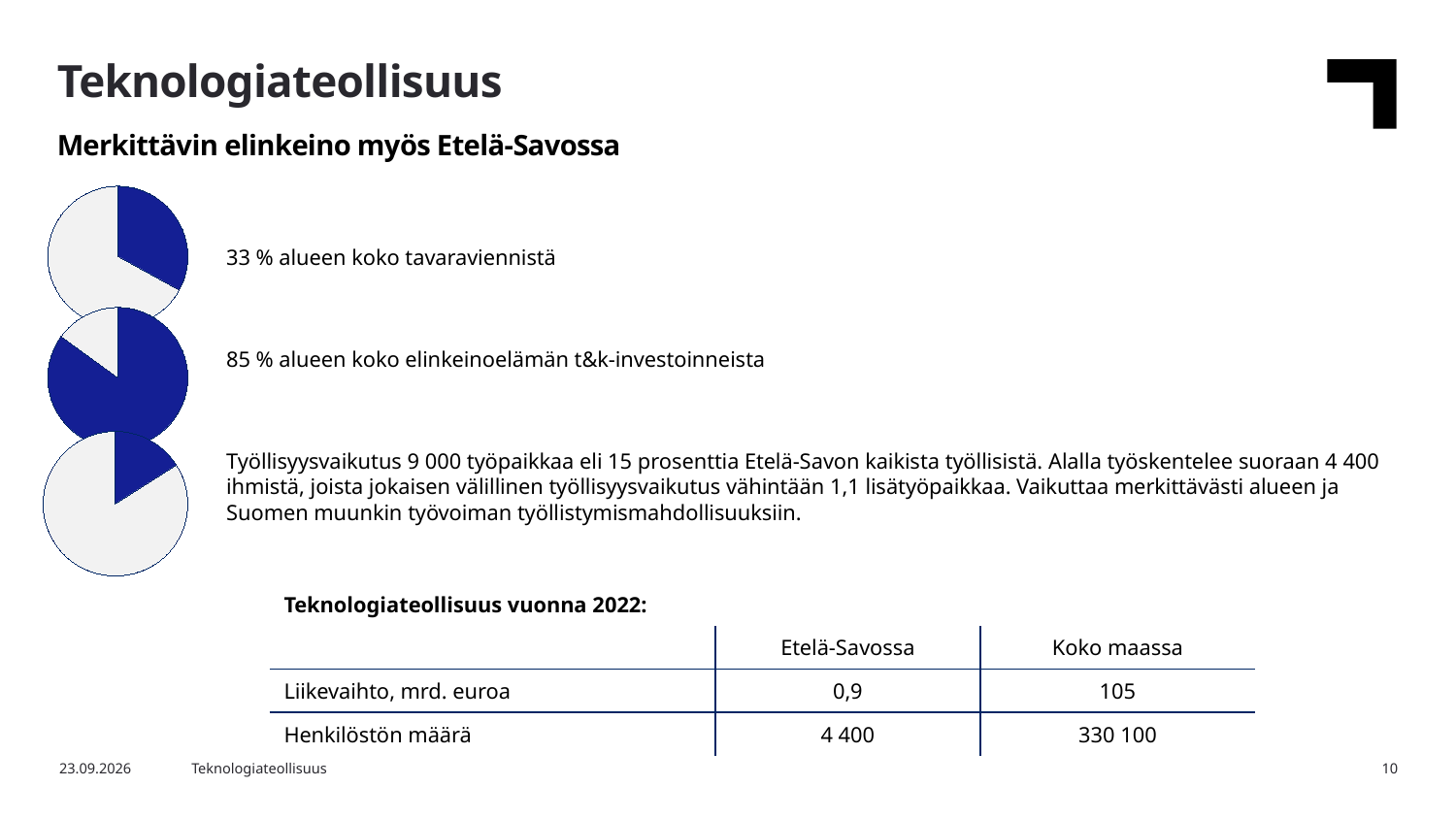
In the top pie chart, what share of the region's total goods exports does the blue slice represent? 33 % What kind of charts are shown on the left side of the slide? Pie charts How many pie charts are on the slide? 3 In the bottom pie chart, what share of all employed people in Etelä-Savo does the blue slice represent? 15 prosenttia How many slices does each pie chart have? 2 Which of the three pie charts has the smallest blue slice? The bottom pie chart (15 prosenttia) In the middle pie chart, what share of the region's business R&D investments does the blue slice represent? 85 % In the middle pie chart, is the blue slice greater or less than 50 %? greater Is the blue slice larger in the top pie chart or in the bottom pie chart? The top pie chart In the top pie chart, is the blue slice greater or less than 50 %? less Which of the three pie charts has the largest blue slice? The middle pie chart (85 %) What colour is the highlighted slice in each pie chart? Blue